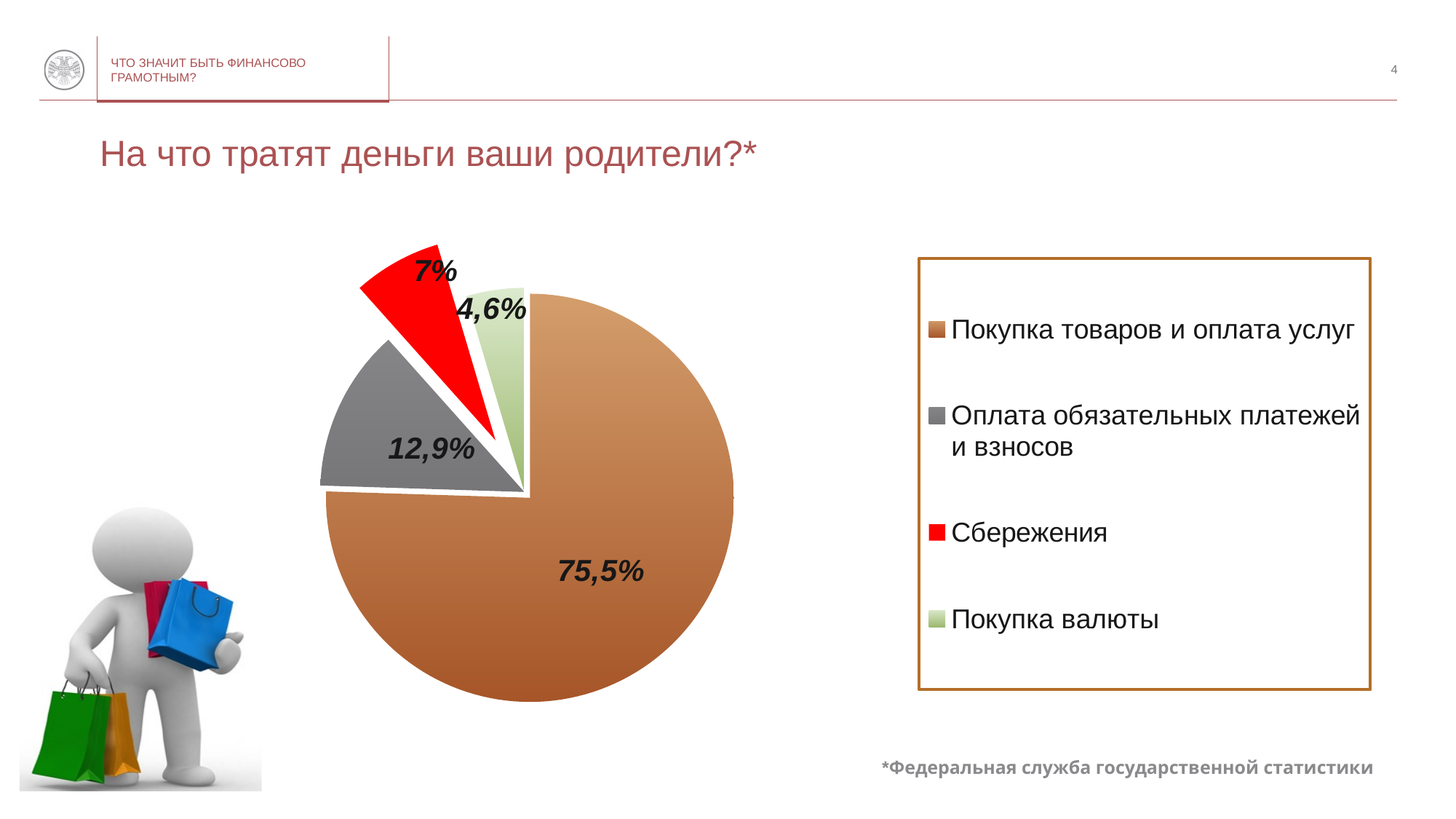
What kind of chart is shown on the slide? pie chart Which category has the smallest slice of the pie? Покупка валюты What value is shown for Сбережения? 7% What is the difference between the values for Оплата обязательных платежей и взносов and Сбережения? 5,9% What is the title of the slide above the chart? На что тратят деньги ваши родители?* What share of the pie is labelled for Покупка товаров и оплата услуг? 75,5% What value is shown for Покупка валюты? 4,6% How many categories does the pie chart have? 4 Which is larger: the slice for Сбережения or the slice for Покупка валюты? Сбережения Which category has the largest slice of the pie? Покупка товаров и оплата услуг What value is shown for Оплата обязательных платежей и взносов? 12,9% What colour is the slice for Сбережения? red